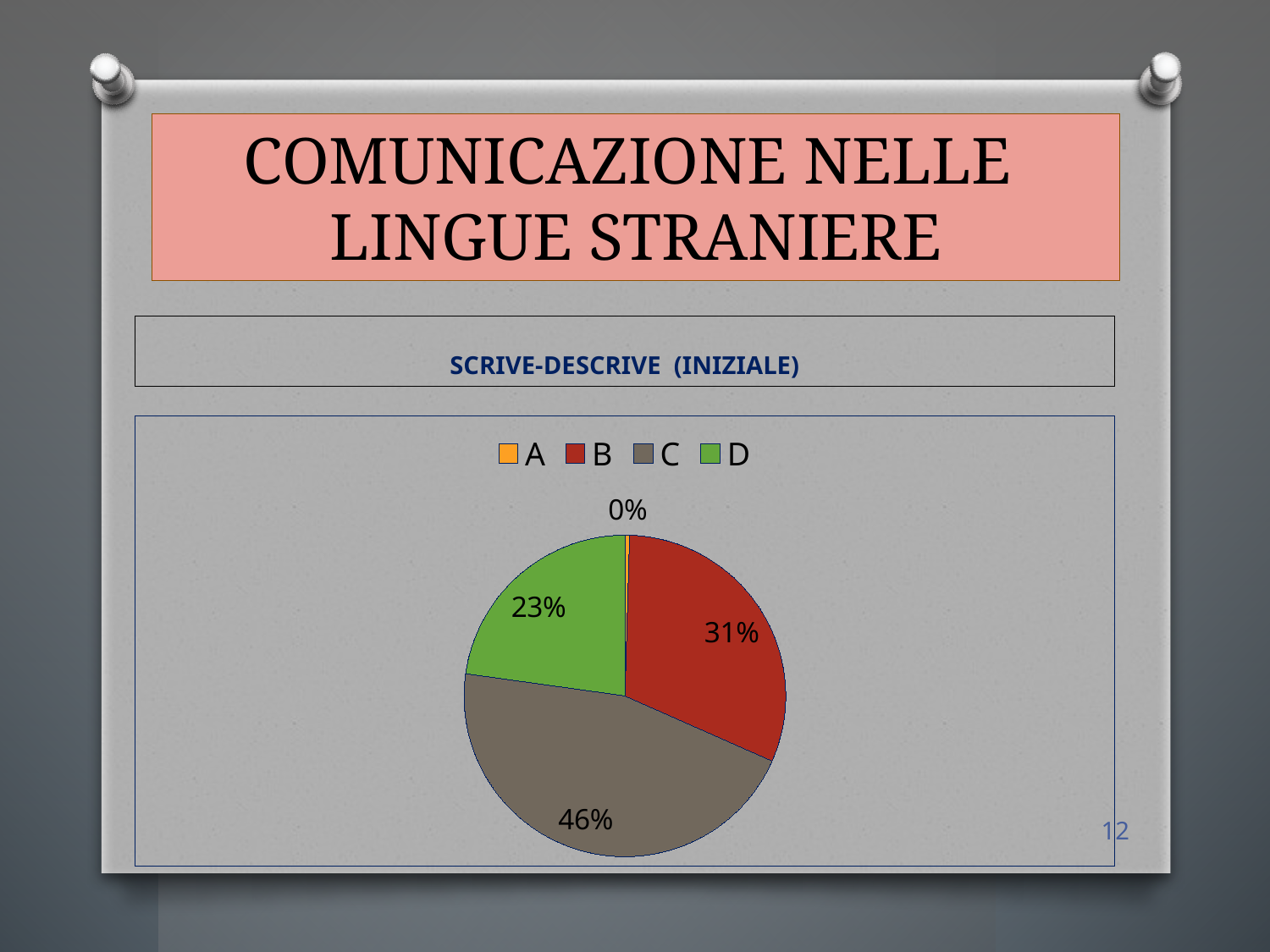
What share of the pie does category B have? 31% What is the difference in percentage points between category B and category D? 8% What is the difference in percentage points between category C and category B? 15% Which is larger, the slice for B or the slice for D? B What kind of chart is shown on the slide? pie chart What share of the pie does category A have? 0% What colour is the slice for category D? green Which category has the smallest slice of the pie? A How many categories does the legend list? 4 Which category has the largest slice of the pie? C What share of the pie does category D have? 23%